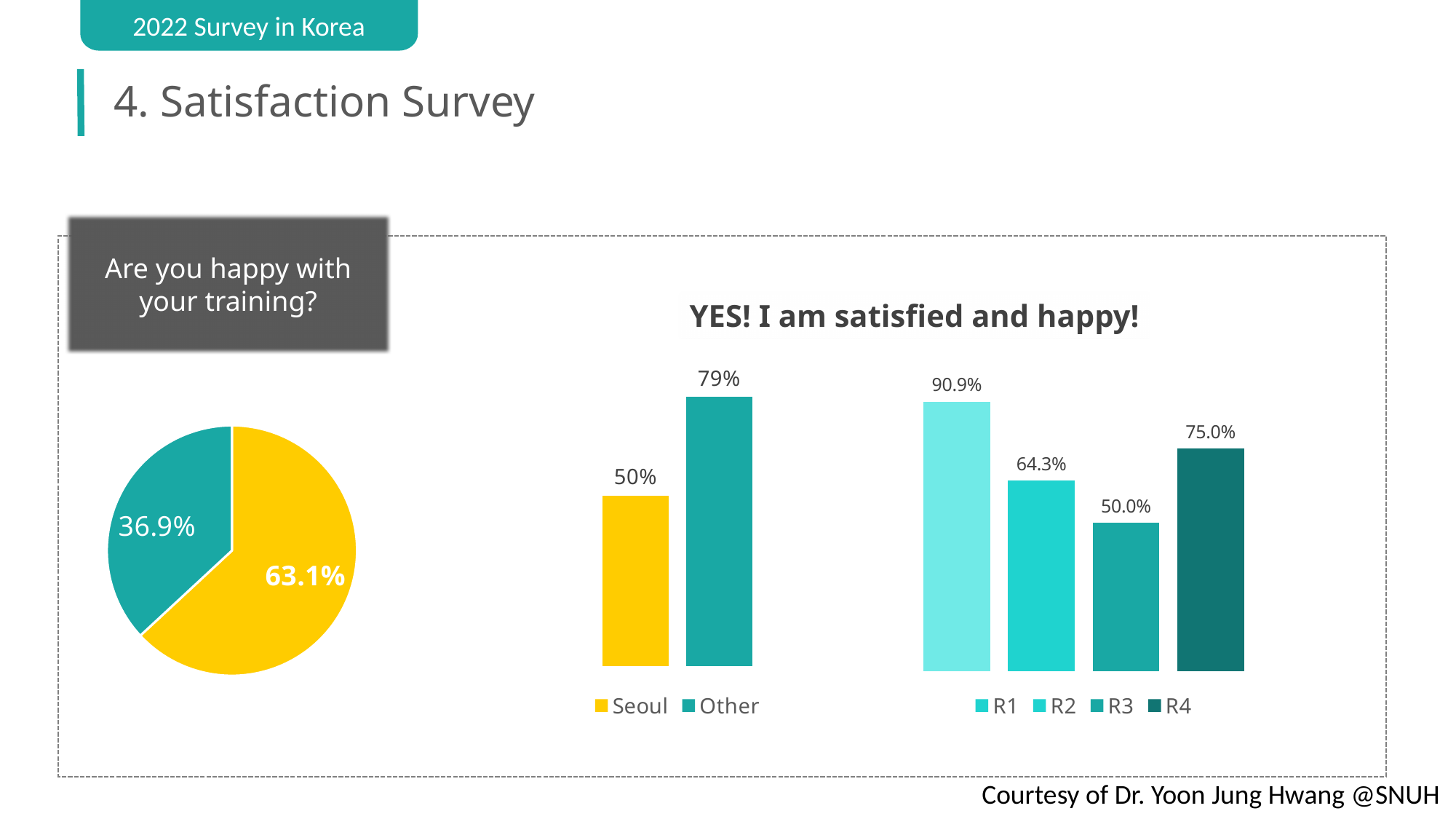
In the right-hand bar chart (R1 to R4), which category has the lowest value? R3 In the middle bar chart, what is the difference between the Other and Seoul values? 29% In the middle bar chart (Seoul vs Other), what is the value for Other? 79% In the right-hand bar chart (R1 to R4), what is the difference between R1 and R2? 26.6% How many series does the legend of the right-hand bar chart list? 4 In the middle bar chart (Seoul vs Other), what is the value for Seoul? 50% In the pie chart on the left, what is the value of the larger slice? 63.1% What kind of chart is the chart on the left of the slide? pie chart What is the title shown above the bar charts? YES! I am satisfied and happy! In the middle bar chart, which is higher, Seoul or Other? Other In the pie chart on the left, what is the value of the smaller (teal) slice? 36.9% In the right-hand bar chart (R1 to R4), what is the value for R1? 90.9%